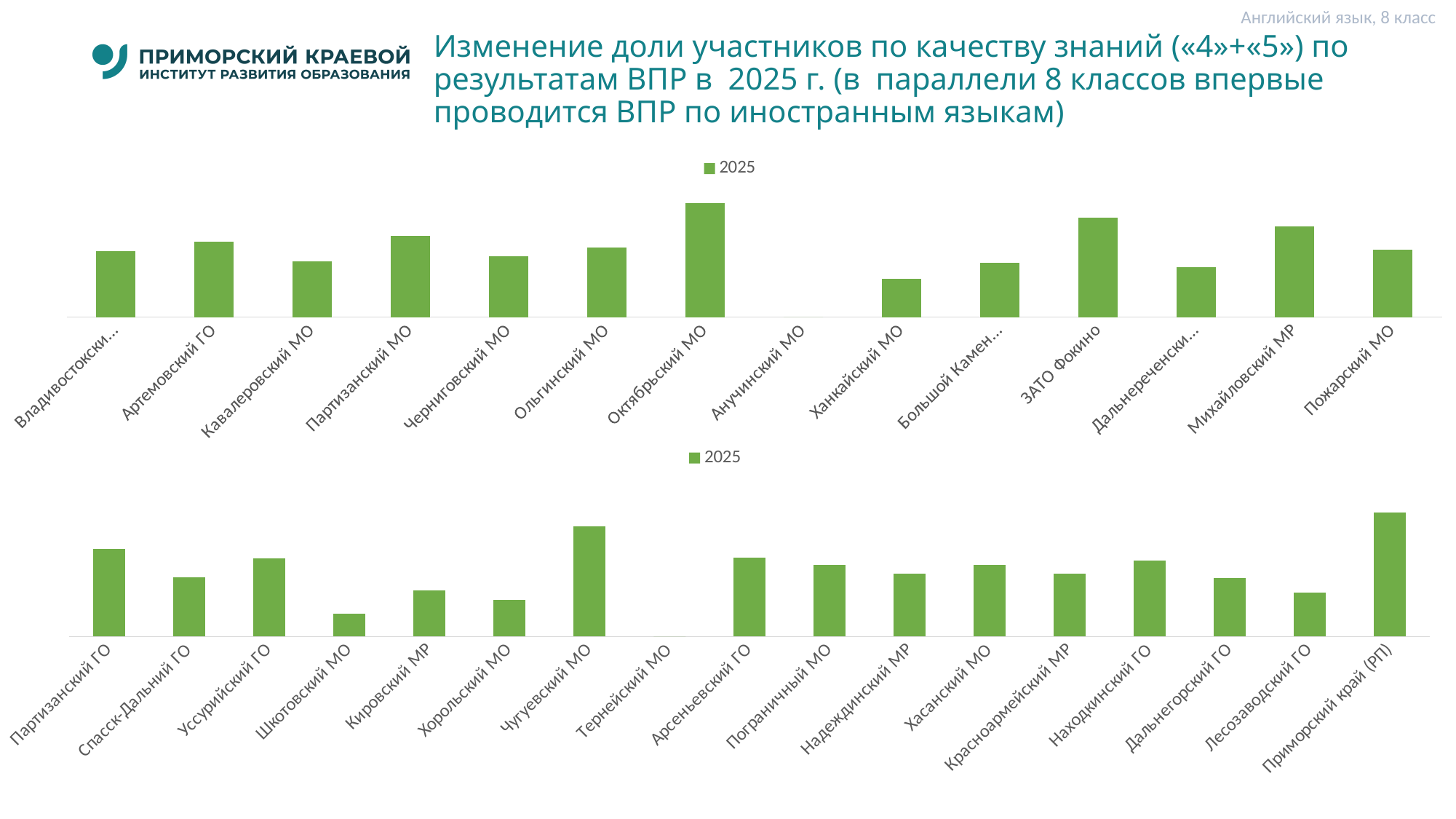
In the bottom chart, which category with a visible bar has the lowest value? Шкотовский МО In the bottom chart, which is larger: the value for Чугуевский МО or for Хорольский МО? Чугуевский МО How many categories are shown on the x axis of the top chart? 14 In the top chart, which category shows no visible bar? Анучинский МО How many categories are shown on the x axis of the bottom chart? 17 In the bottom chart, which category has the tallest bar? Приморский край (РП) How many series does the legend of the top chart list? 1 What kind of chart is the top chart on the slide? bar chart In the top chart, which is larger: the value for Партизанский МО or for Кавалеровский МО? Партизанский МО What is the legend entry shown for the bottom chart? 2025 In the top chart, which category has the tallest bar? Октябрьский МО In the bottom chart, which is larger: the value for Партизанский ГО or for Спасск-Дальний ГО? Партизанский ГО